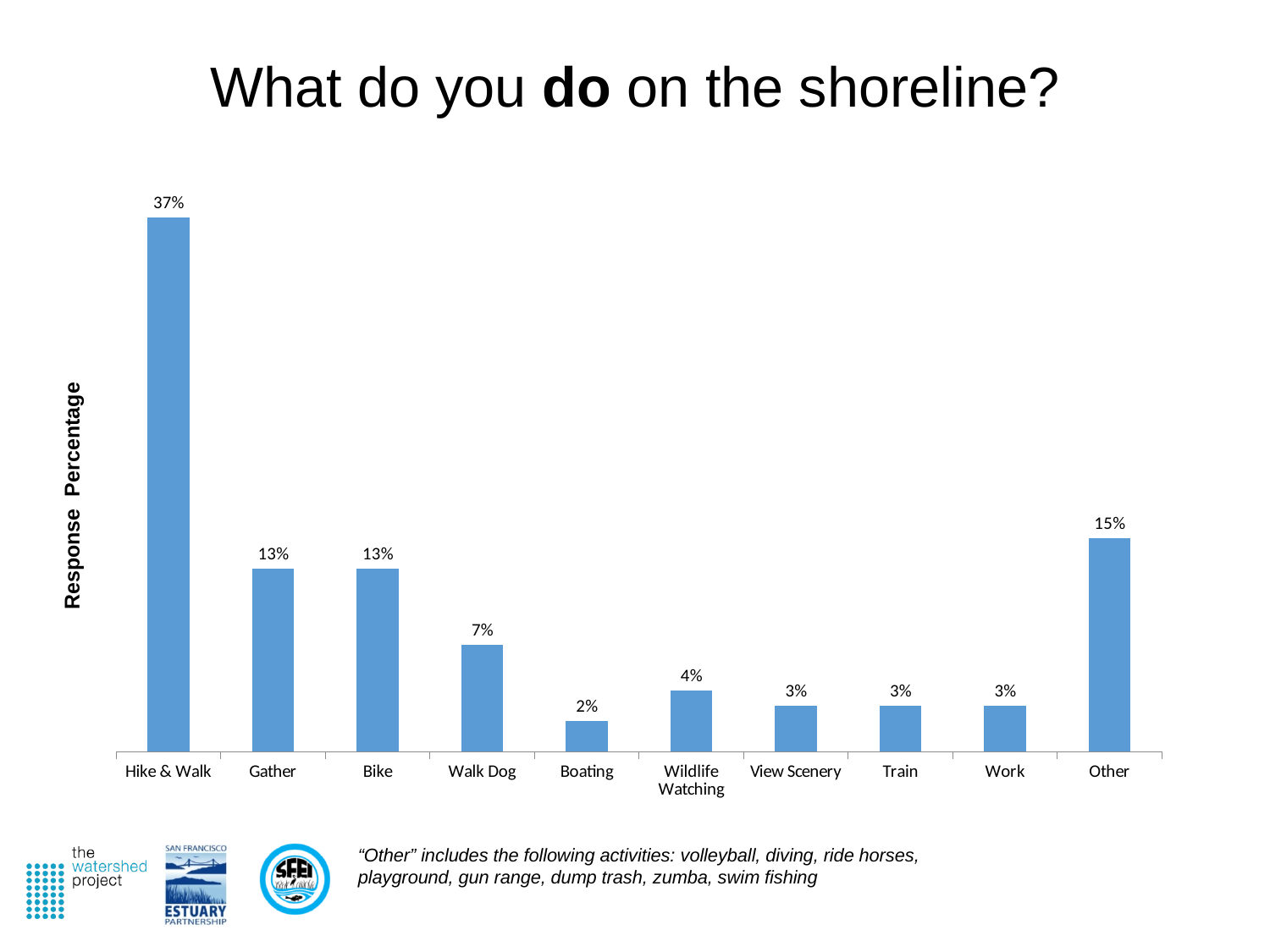
Which has a higher response percentage, Wildlife Watching or Boating? Wildlife Watching Which has a higher response percentage, Other or Bike? Other Which activity has the highest response percentage? Hike & Walk What is the response percentage for Hike & Walk? 37% What is the response percentage for Other? 15% What is the label on the vertical axis of the chart? Response Percentage Which activity has the lowest response percentage? Boating How many activity categories are shown on the chart? 10 What is the response percentage for Walk Dog? 7% What is the difference in response percentage between Gather and Walk Dog? 6% What is the difference in response percentage between Hike & Walk and Other? 22% What kind of chart is shown on the slide? Bar chart